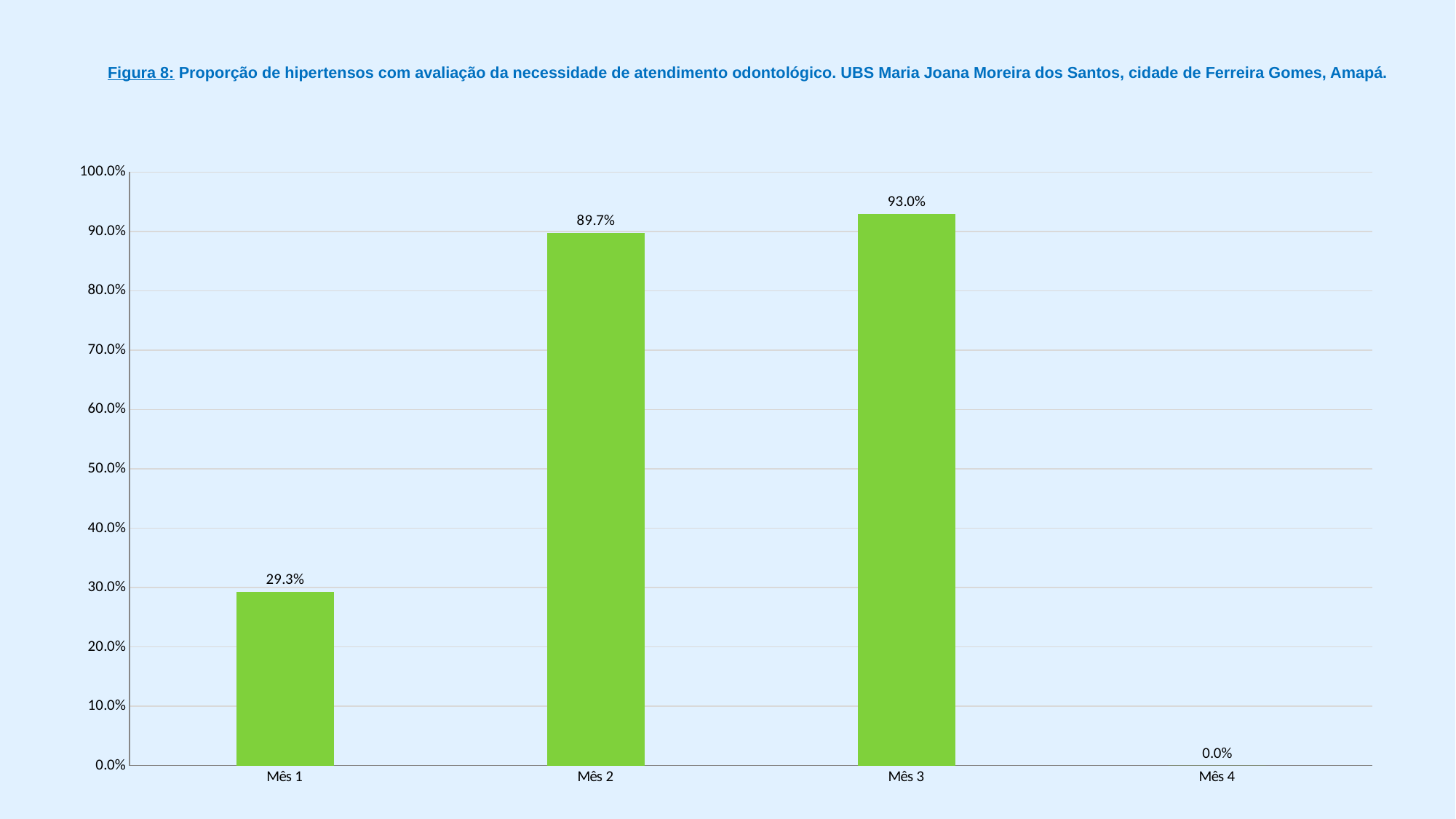
Which is larger, the value for Mês 1 or the value for Mês 2? Mês 2 What is the value for Mês 2? 89.7% What is the value for Mês 4? 0.0% What kind of chart is shown on the slide? Bar chart How many months are shown on the x axis? 4 Which month has the lowest value? Mês 4 What is the value for Mês 3? 93.0% Is the value for Mês 1 greater or less than 30.0%? less Which month has the highest value? Mês 3 What is the difference between the values for Mês 2 and Mês 1? 60.4% What is the difference between the values for Mês 3 and Mês 2? 3.3% What is the value for Mês 1? 29.3%